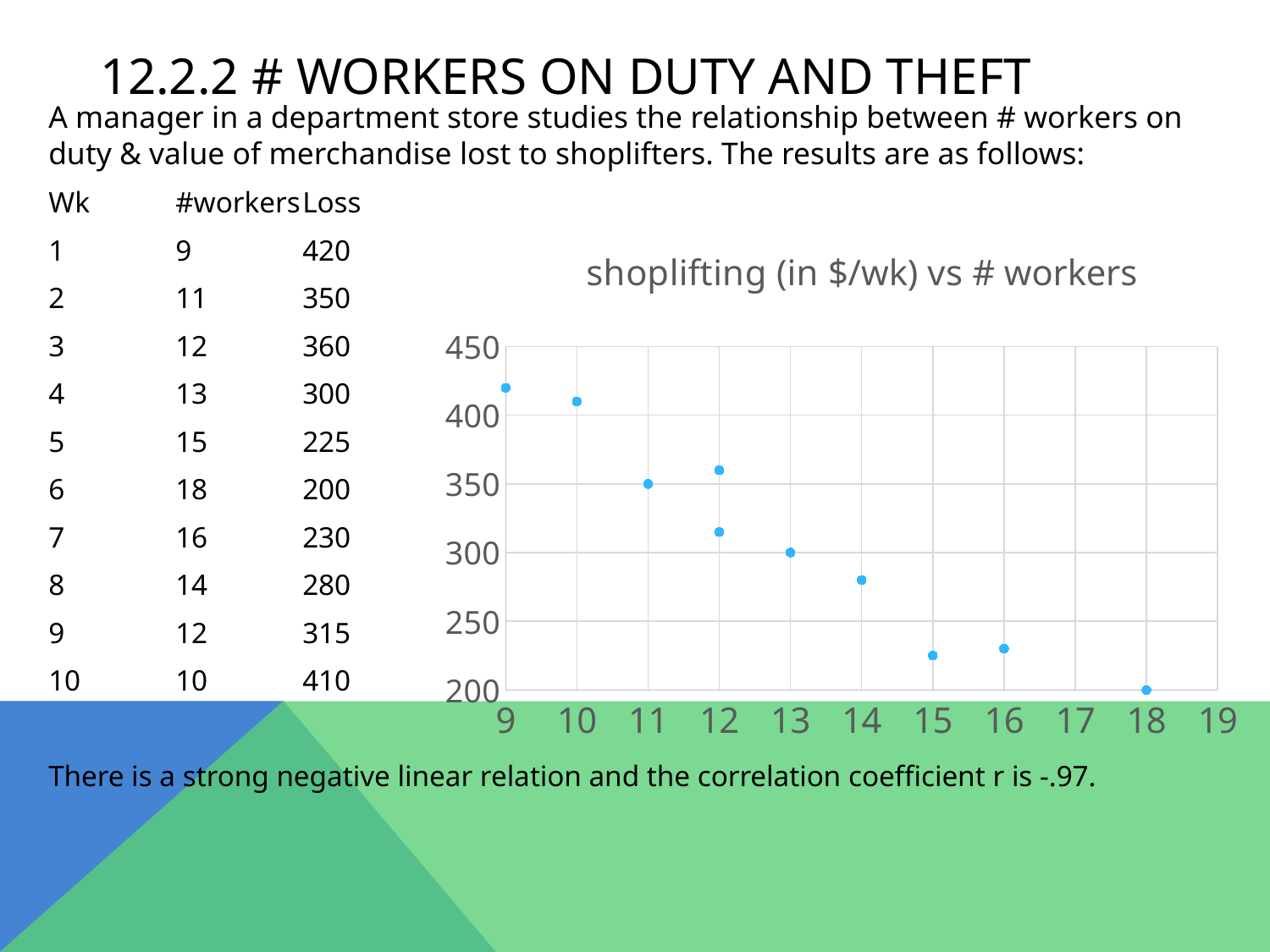
According to the slide, what is the loss when 9 workers are on duty? 420 Which number of workers corresponds to the highest loss on the chart? 9 What is the difference between the loss at 9 workers and the loss at 18 workers? 220 What is the title of the chart? shoplifting (in $/wk) vs # workers Is the loss at 14 workers greater or less than 300? less Which is larger, the loss at 11 workers or the loss at 13 workers? 11 workers How many data points are plotted on the chart? 10 Which number of workers corresponds to the lowest loss on the chart? 18 According to the slide, what is the loss when 18 workers are on duty? 200 What kind of chart is shown on the slide? scatter chart Do the loss values rise or fall as the number of workers increases along the x axis? fall According to the slide, what is the loss when 15 workers are on duty? 225